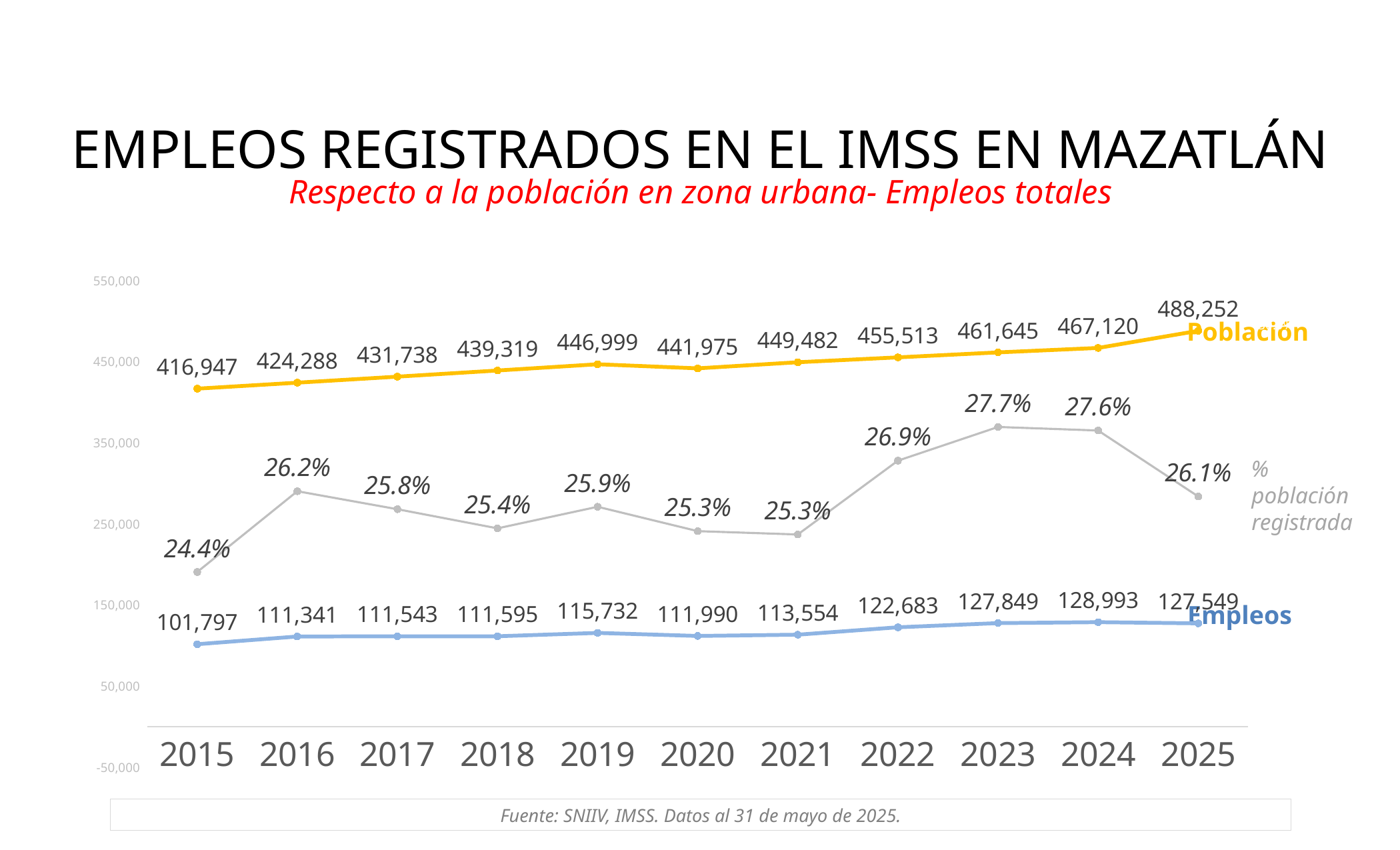
What is the value of the Empleos series for 2019? 115,732 How many data series are plotted on the chart? 3 What is the value of the Población series for 2025? 488,252 What is the % población registrada value for 2023? 27.7% What kind of chart is shown on the slide? Line chart In which year is the Empleos series highest? 2024 Which is larger, the Población value for 2019 or for 2020? 2019 What is the difference between the Empleos value for 2025 and the Empleos value for 2015? 25,752 Does the Población series rise or fall from 2015 to 2025? Rise In which year is the % población registrada series lowest? 2015 What is the difference between the Población value for 2025 and the Población value for 2024? 21,132 How many years are shown on the x axis? 11